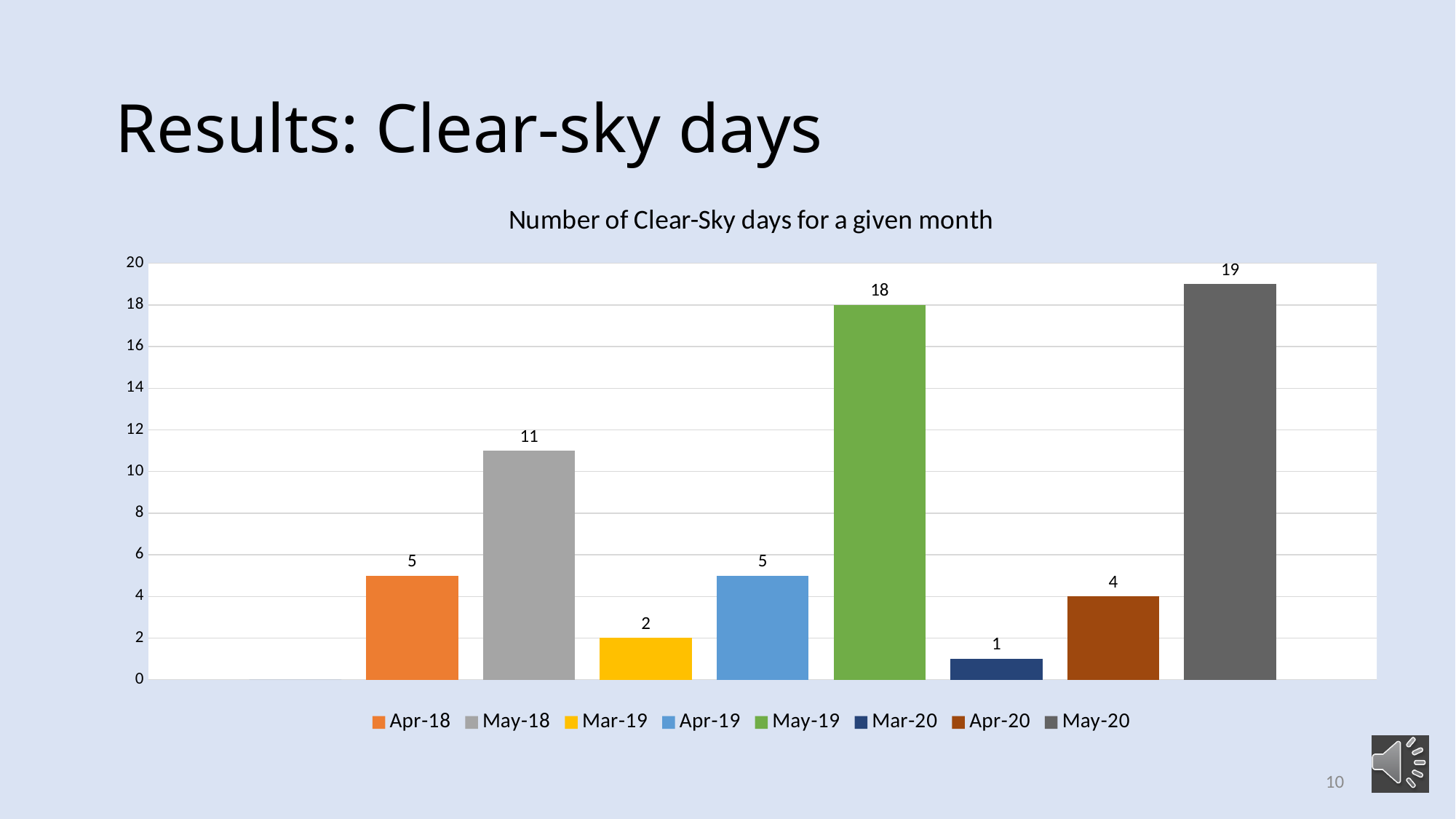
What is the value for May-18 in the chart? 11 What is the value for May-19 in the chart? 18 Which month has the lowest number of clear-sky days? Mar-20 What is the value for Apr-20 in the chart? 4 Which month has the highest number of clear-sky days? May-20 What kind of chart is shown on the slide? Bar chart What is the difference between the values for May-18 and Mar-19? 9 What is the difference between the values for May-20 and May-19? 1 How many series does the legend list? 8 What is the value for Mar-20 in the chart? 1 What is the title of the chart? Number of Clear-Sky days for a given month Which is larger, the value for Apr-20 or the value for Mar-19? Apr-20